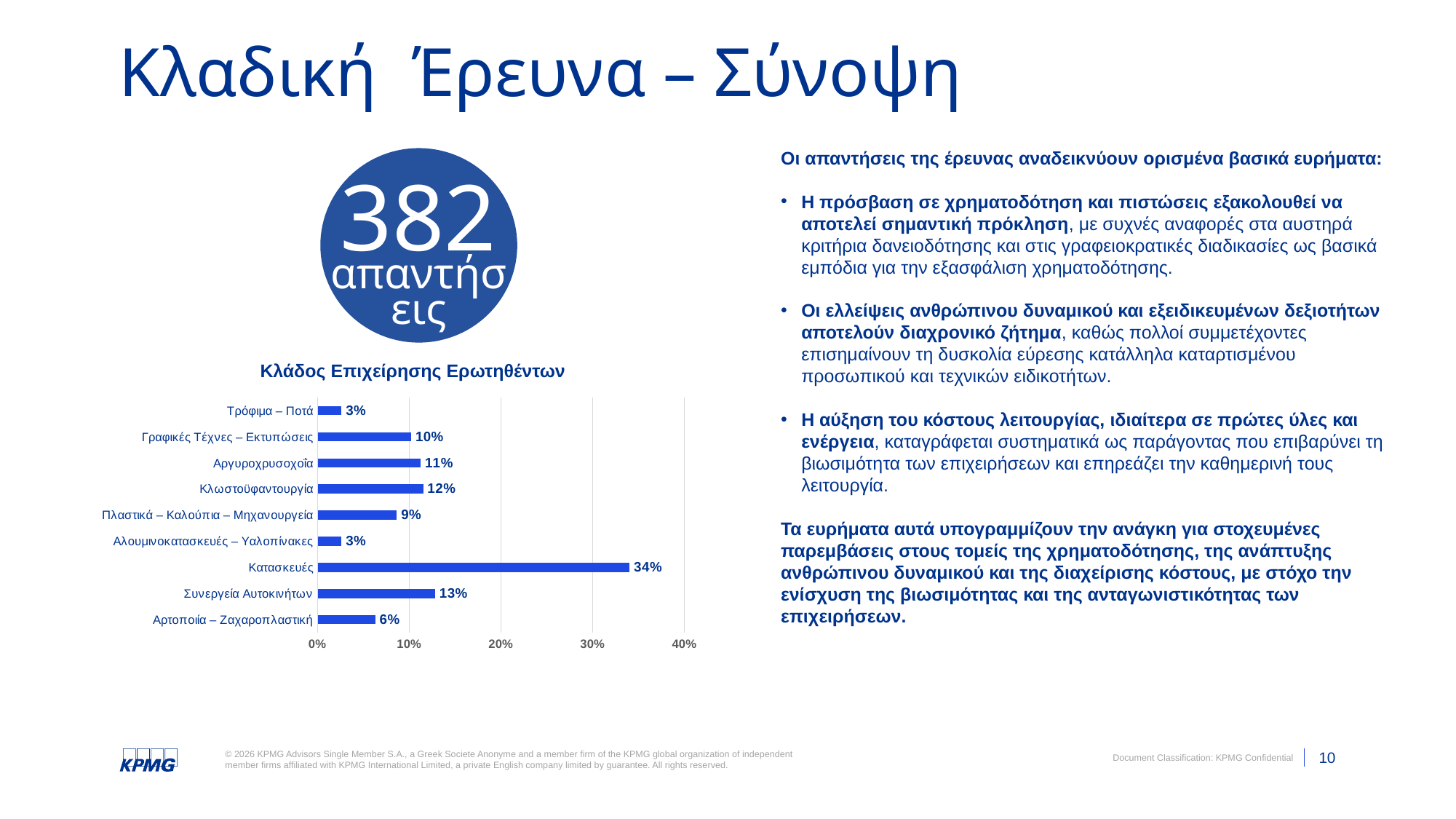
Which is larger, the value for Αργυροχρυσοχοΐα or the value for Γραφικές Τέχνες – Εκτυπώσεις? Αργυροχρυσοχοΐα What kind of chart is shown on the slide? bar chart What is the difference between the values for Κλωστοϋφαντουργία and Πλαστικά – Καλούπια – Μηχανουργεία? 3% What is the title of the chart? Κλάδος Επιχείρησης Ερωτηθέντων What is the value for Κατασκευές in the chart? 34% Is the value for Κατασκευές greater or less than 30%? greater How many categories are shown in the chart? 9 What is the difference between the values for Κατασκευές and Συνεργεία Αυτοκινήτων? 21% What is the value for Συνεργεία Αυτοκινήτων? 13% What is the value for Αρτοποιία – Ζαχαροπλαστική? 6% What is the value for Κλωστοϋφαντουργία? 12% Which category has the highest value in the chart? Κατασκευές